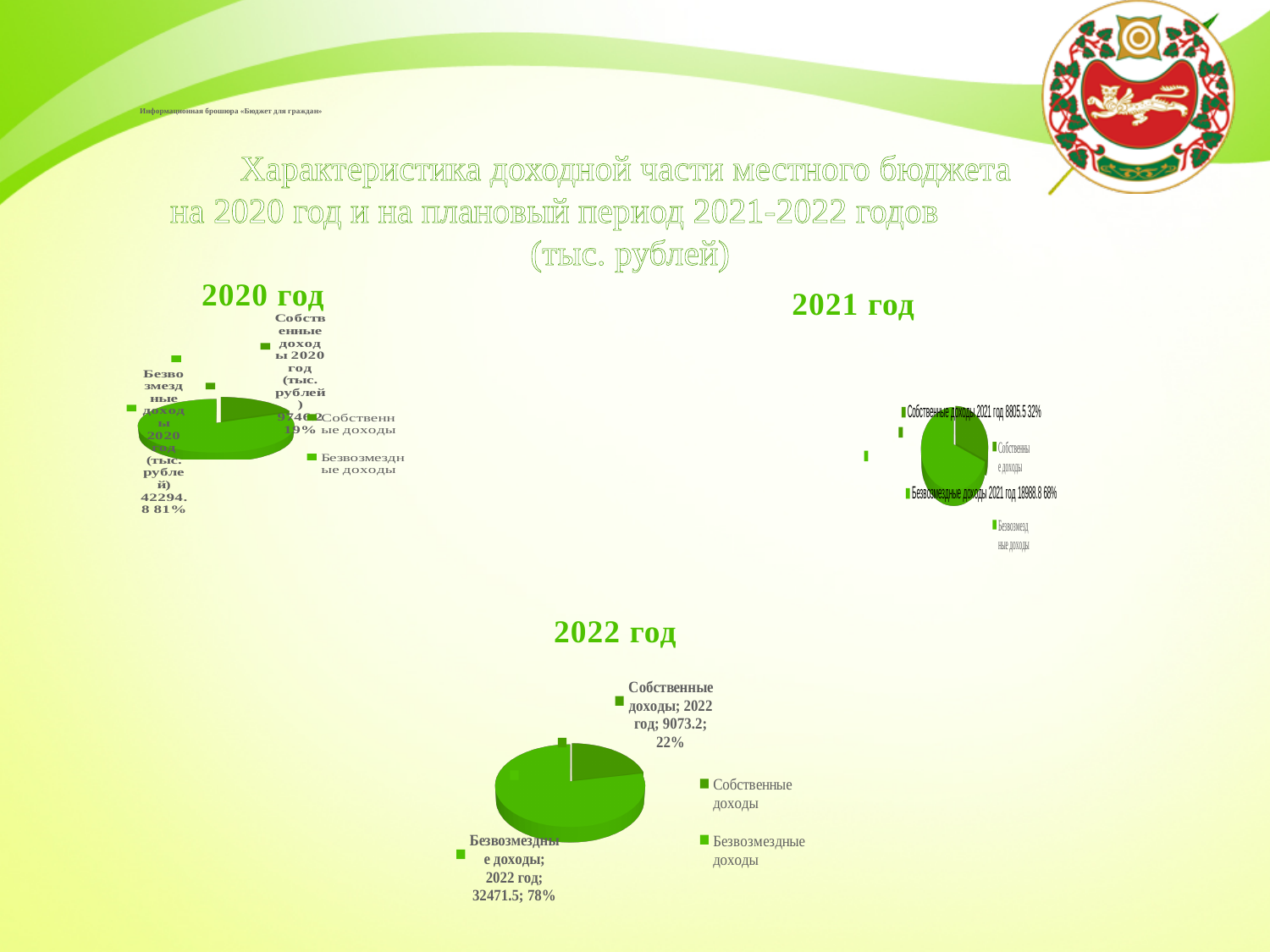
In the "2020 год" chart, which is larger: Собственные доходы or Безвозмездные доходы? Безвозмездные доходы How many slices does the "2022 год" pie chart have? 2 In the "2021 год" chart, which category has the largest slice? Безвозмездные доходы In the "2022 год" chart, what is the value for Безвозмездные доходы? 32471.5 In the "2022 год" chart, what share of the pie is Собственные доходы? 22% In the "2020 год" chart, what share of the pie is Безвозмездные доходы? 81% In the "2022 год" chart, what is the difference between Безвозмездные доходы and Собственные доходы? 23398.3 In the "2021 год" chart, what is the value for Собственные доходы? 8805.5 In the "2020 год" chart, what is the value for Безвозмездные доходы? 42294.8 In the "2021 год" chart, what share of the pie is Безвозмездные доходы? 68% What kind of chart is the "2022 год" chart? pie chart In the "2021 год" chart, what is the total of the two slices? 27794.3